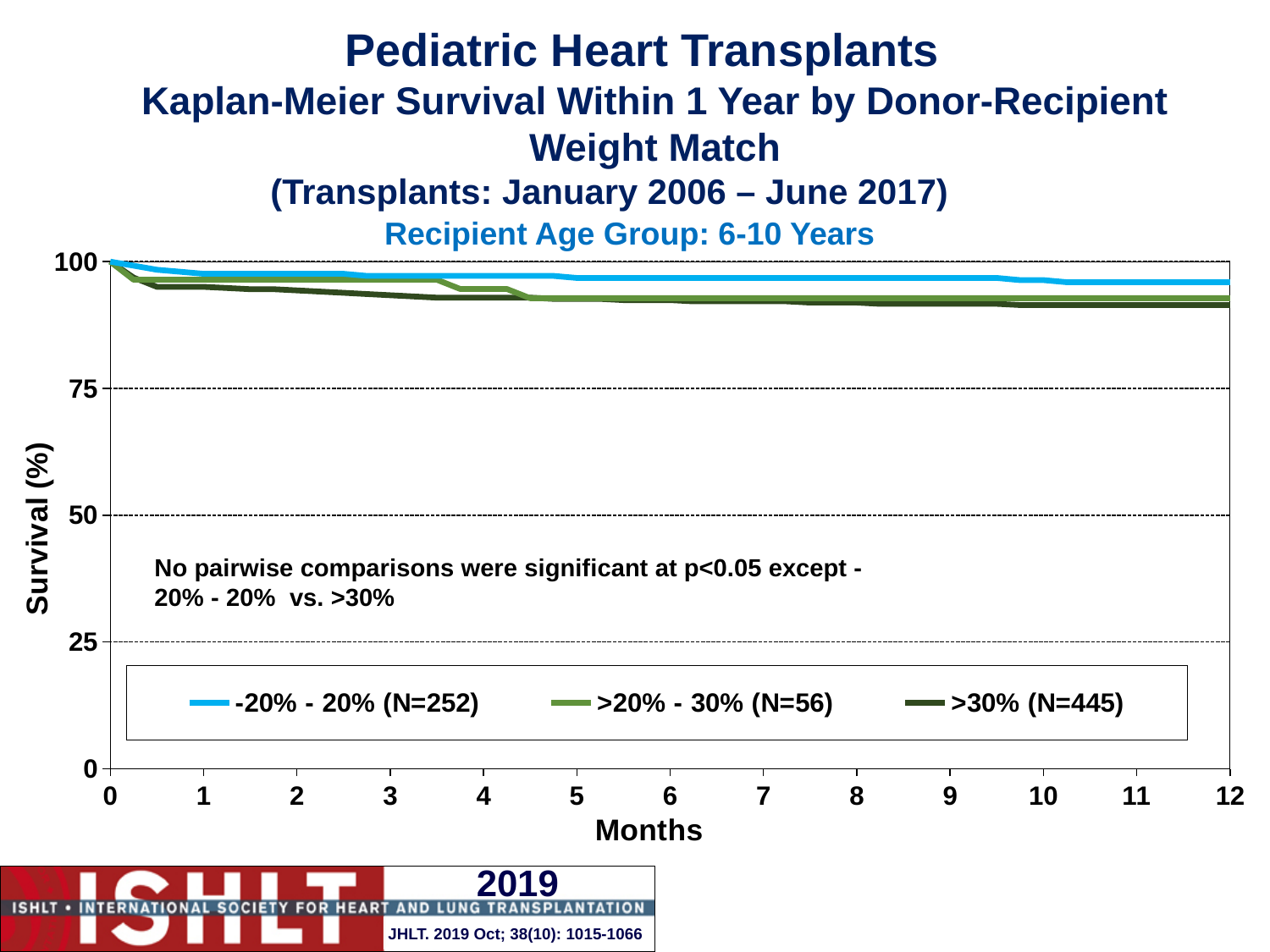
Is the survival value for the >30% group at 12 months greater or less than 75? greater At 12 months, which group has higher survival: -20% - 20% or >30%? -20% - 20% How many series does the legend list? 3 What is the survival value at 0 months for the -20% - 20% group? 100 Which group has the largest N in the legend? >30% (N=445) What is the N for the -20% - 20% group shown in the legend? 252 What kind of chart is shown on the slide? line chart Which group has the lowest survival at 2 months? >30% (N=445) Do the survival curves rise or fall as months increase? fall Which group has the highest survival at 12 months? -20% - 20% (N=252) Is the survival value for the -20% - 20% group at 12 months greater or less than 75? greater Is the survival value for the >20% - 30% group at 6 months greater or less than 50? greater